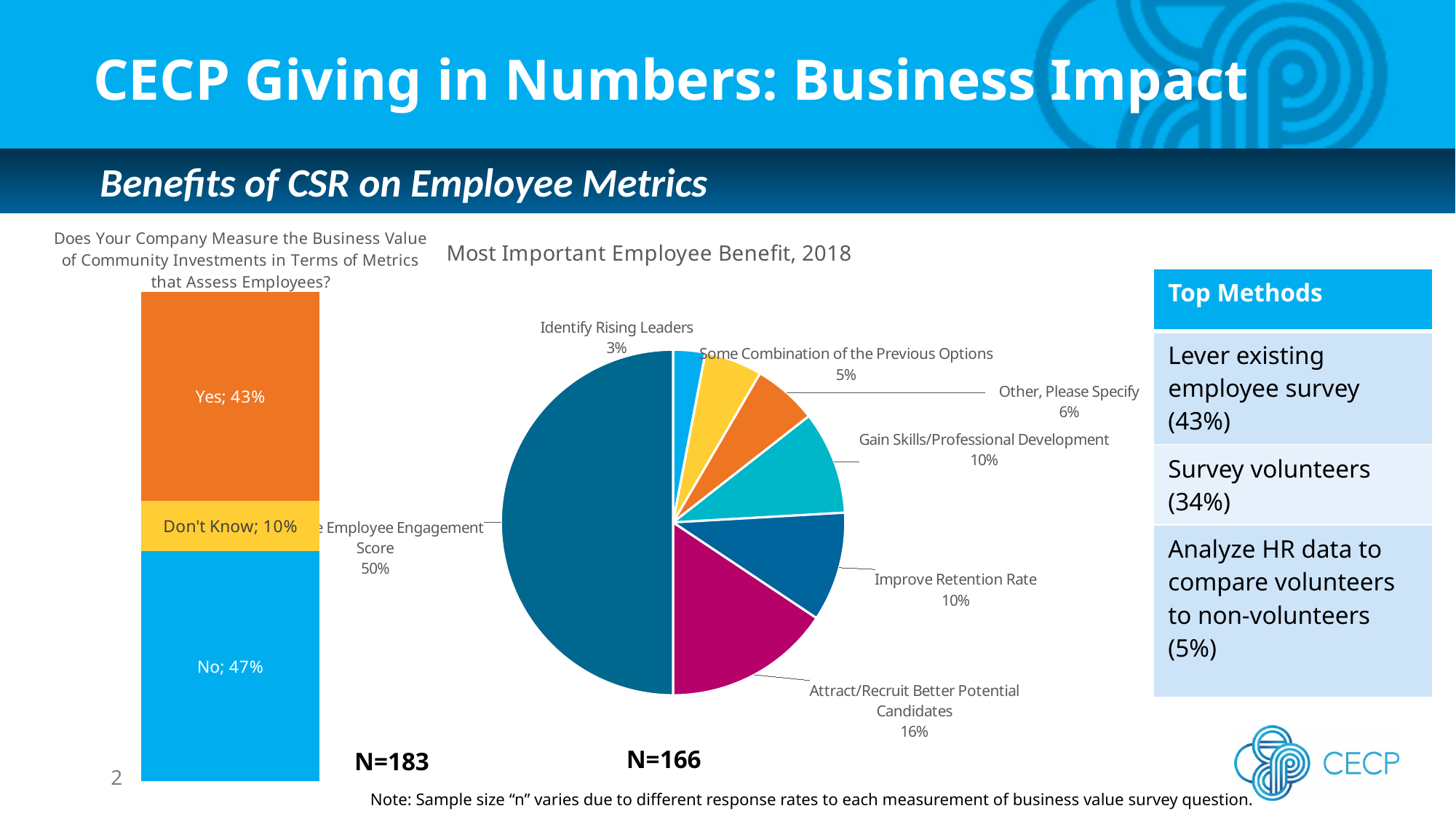
In the pie chart 'Most Important Employee Benefit, 2018', what percentage is shown for Attract/Recruit Better Potential Candidates? 16% In the pie chart 'Most Important Employee Benefit, 2018', which is larger: Gain Skills/Professional Development or Some Combination of the Previous Options? Gain Skills/Professional Development What sample size (N) is shown beneath the pie chart 'Most Important Employee Benefit, 2018'? N=166 How many slices does the pie chart 'Most Important Employee Benefit, 2018' have? 7 In the bar chart on the left of the slide, what percentage answered 'No'? 47% In the bar chart on the left of the slide, what percentage answered 'Don't Know'? 10% In the pie chart 'Most Important Employee Benefit, 2018', what is the difference in percentage points between Attract/Recruit Better Potential Candidates and Other, Please Specify? 10 In the pie chart 'Most Important Employee Benefit, 2018', which category has the smallest slice? Identify Rising Leaders In the pie chart 'Most Important Employee Benefit, 2018', which category has the largest slice? Employee Engagement Score What type of chart is the chart on the left of the slide, titled 'Does Your Company Measure the Business Value of Community Investments in Terms of Metrics that Assess Employees?'? Bar chart In the bar chart on the left of the slide, what is the difference in percentage points between 'No' and 'Yes'? 4 In the pie chart 'Most Important Employee Benefit, 2018', what percentage is shown for Identify Rising Leaders? 3%